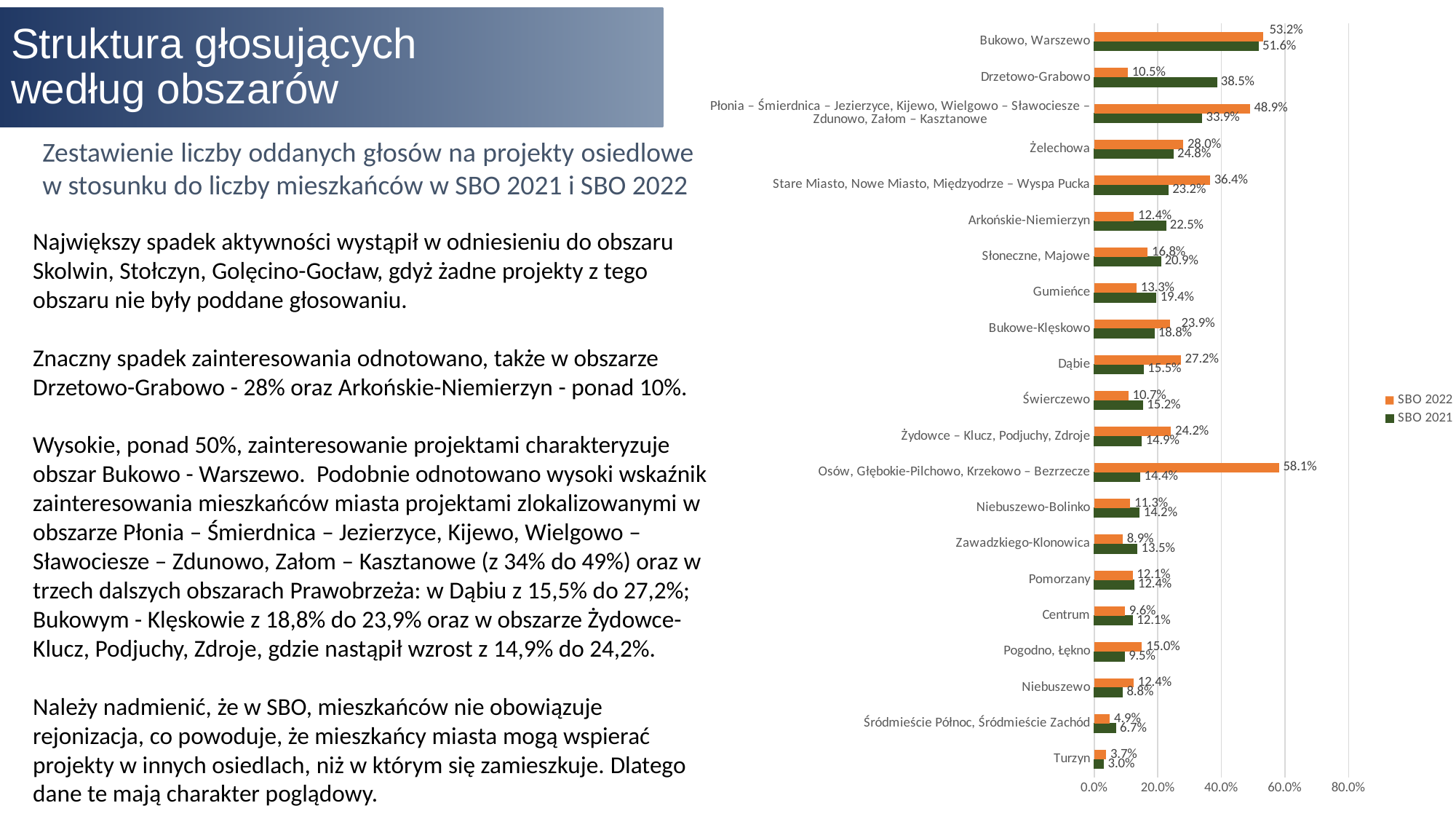
How many areas are shown in the chart? 21 What type of chart is shown on the slide? Bar chart Which area has the highest SBO 2021 value? Bukowo, Warszewo What is the SBO 2022 value for Drzetowo-Grabowo? 10.5% What is the SBO 2022 value for Dąbie? 27.2% How many series does the legend list? 2 Which area has the lowest SBO 2021 value? Turzyn For Żydowce – Klucz, Podjuchy, Zdroje, which is larger: the SBO 2022 value or the SBO 2021 value? SBO 2022 Is the SBO 2022 value for Osów, Głębokie-Pilchowo, Krzekowo – Bezrzecze greater or less than 40.0%? greater What is the difference between the SBO 2021 and SBO 2022 values for Drzetowo-Grabowo? 28.0 percentage points What is the SBO 2021 value for Arkońskie-Niemierzyn? 22.5% Which area has the highest SBO 2022 value? Osów, Głębokie-Pilchowo, Krzekowo – Bezrzecze